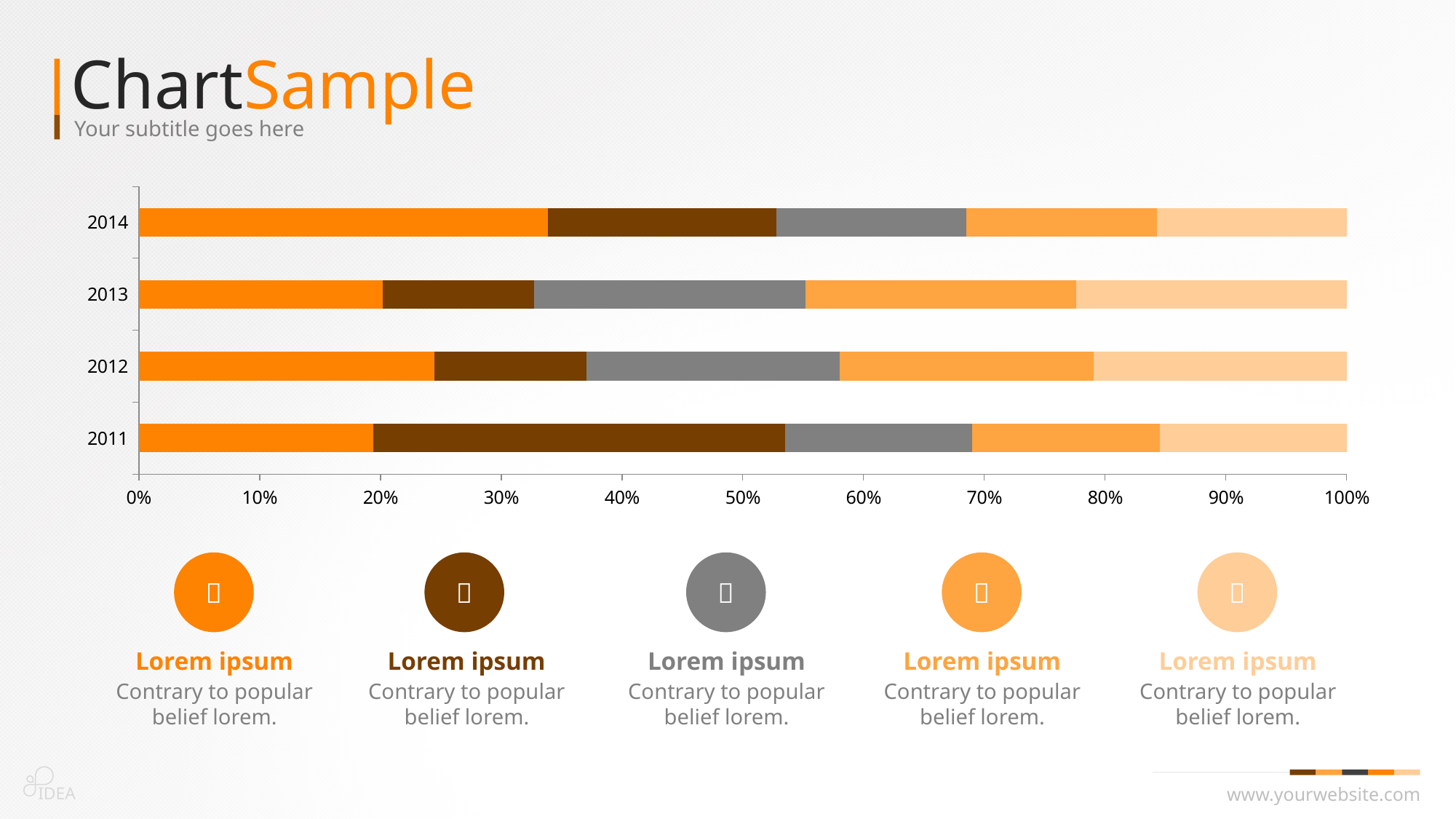
Is the value of the dark brown segment for 2011 greater or less than 30%? greater What kind of chart is shown on the slide? bar chart Which year has the largest first (bright orange) segment? 2014 Which year has the largest dark brown segment? 2011 Is the value of the first (bright orange) segment for 2014 greater or less than 30%? greater How many years are plotted on the chart? 4 What is the total of the stacked bar for 2014? 100% Is the value of the first (bright orange) segment for 2012 greater or less than 30%? less Is the first (bright orange) segment larger for 2014 or for 2013? 2014 What is the title of the slide containing the chart? Chart Sample How many series does the legend below the chart list? 5